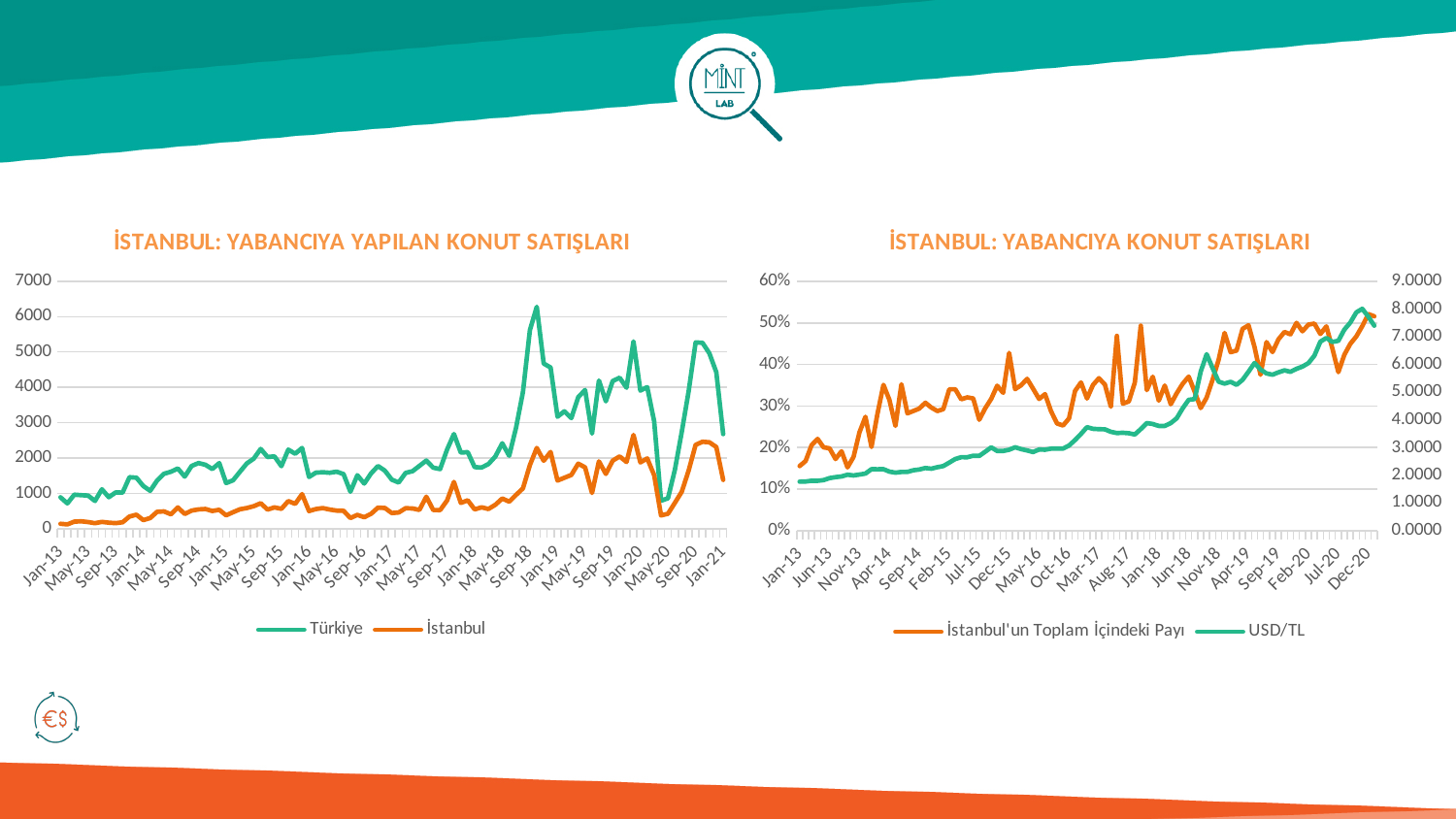
In the right chart, does the USD/TL series generally rise or fall from Jan-13 to Dec-20? rise In the right chart, is the value for İstanbul'un Toplam İçindeki Payı in Jan-13 greater or less than 20%? less In the left chart, is the value for İstanbul in Jan-13 greater or less than 1000? less In the left chart, is the value for Türkiye at its dip around May-20 greater or less than 1000? less How many series does the legend of the right chart list? 2 What is the title of the right chart? İSTANBUL: YABANCIYA KONUT SATIŞLARI What type of chart is the left chart titled 'İSTANBUL: YABANCIYA YAPILAN KONUT SATIŞLARI'? Line chart How many series does the legend of the left chart list? 2 In the left chart, which series has the higher values throughout the period, Türkiye or İstanbul? Türkiye What are the two series named in the legend of the left chart? Türkiye and İstanbul